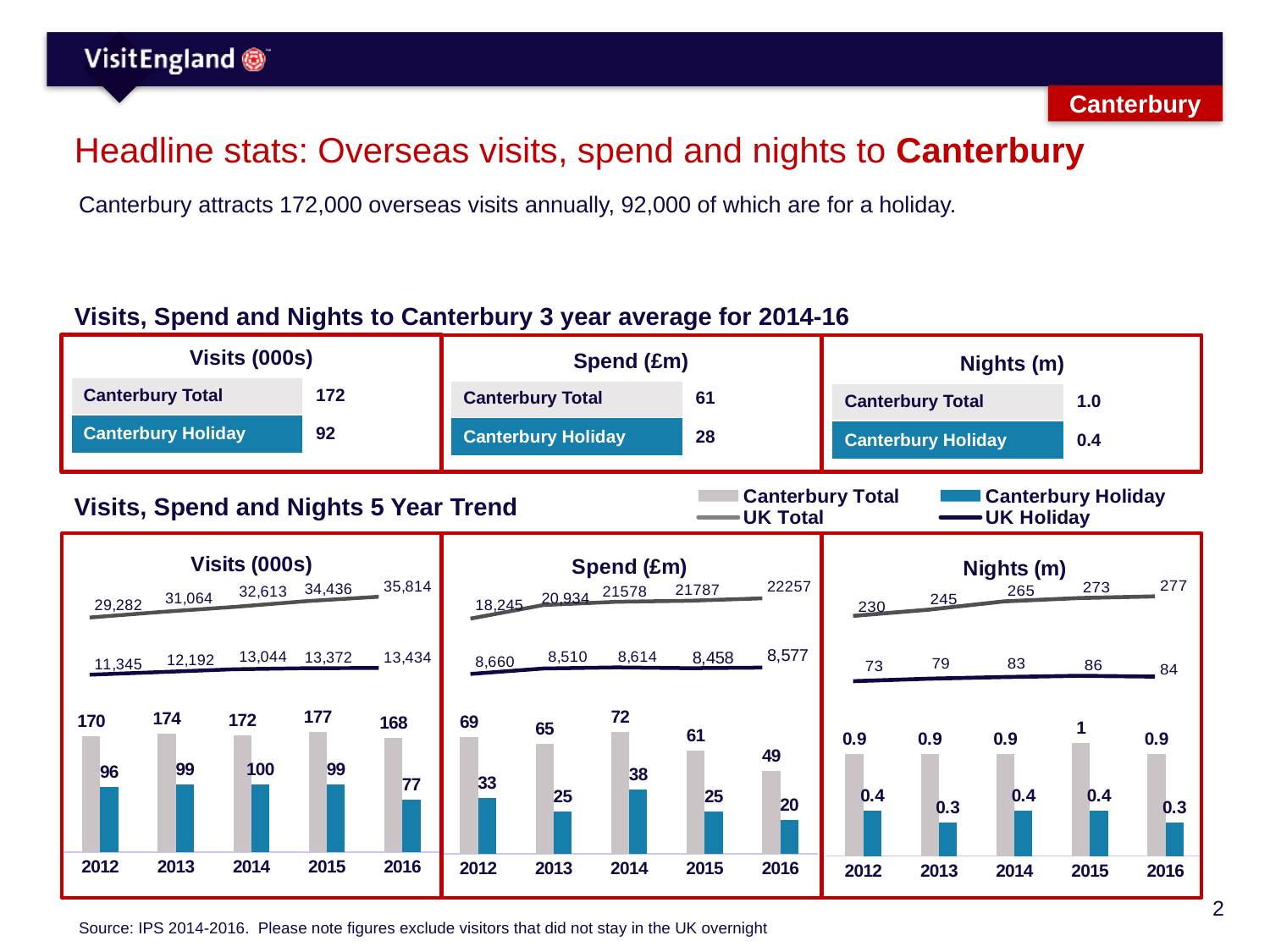
How many years are shown on the x axis of the Spend (£m) 5 Year Trend chart? 5 In the Spend (£m) 5 Year Trend chart, what is the difference between the Canterbury Total and Canterbury Holiday values for 2016? 29 In the Nights (m) 5 Year Trend chart, which is larger: the UK Holiday value for 2015 or for 2016? 2015 In the Nights (m) 5 Year Trend chart, does the UK Total line rise or fall from 2012 to 2016? rise In the Visits (000s) 5 Year Trend chart, which year has the lowest Canterbury Holiday value? 2016 In the Spend (£m) 5 Year Trend chart, what is the UK Holiday value for 2012? 8,660 What kind of chart is used for the Canterbury Total and Canterbury Holiday series in the Visits (000s) 5 Year Trend chart? bar chart In the Nights (m) 5 Year Trend chart, what is the Canterbury Holiday value for 2013? 0.3 How many series does the legend for the 5 Year Trend charts list? 4 In the Visits (000s) 5 Year Trend chart, what is the UK Total value for 2016? 35,814 In the Visits (000s) 5 Year Trend chart, what is the Canterbury Total value for 2015? 177 In the Spend (£m) 5 Year Trend chart, which year has the highest Canterbury Total value? 2014